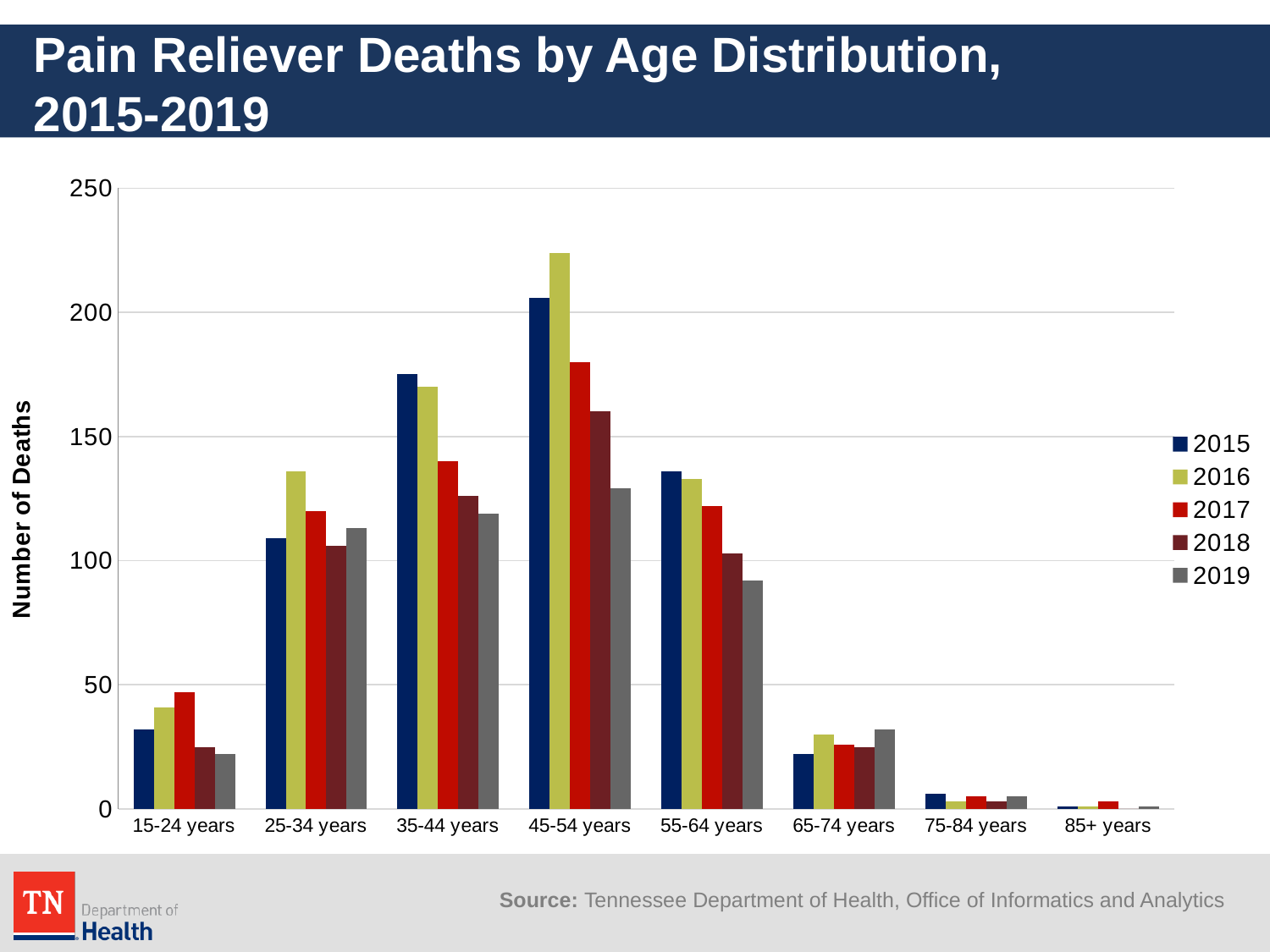
How many age groups are shown on the x axis? 8 What kind of chart is shown on the slide? bar chart Which age group has the highest number of deaths for 2016? 45-54 years Is the 2015 value for 35-44 years greater or less than 150? greater How many series does the legend list? 5 Which age group has the lowest number of deaths for 2015? 85+ years Is the 2015 value for 15-24 years greater or less than 50? less For 55-64 years, which is larger: the 2015 value or the 2019 value? 2015 Is the 2016 value for 45-54 years greater or less than 200? greater What is the title of the y axis? Number of Deaths For 45-54 years, do the values rise or fall from 2016 through 2019? fall